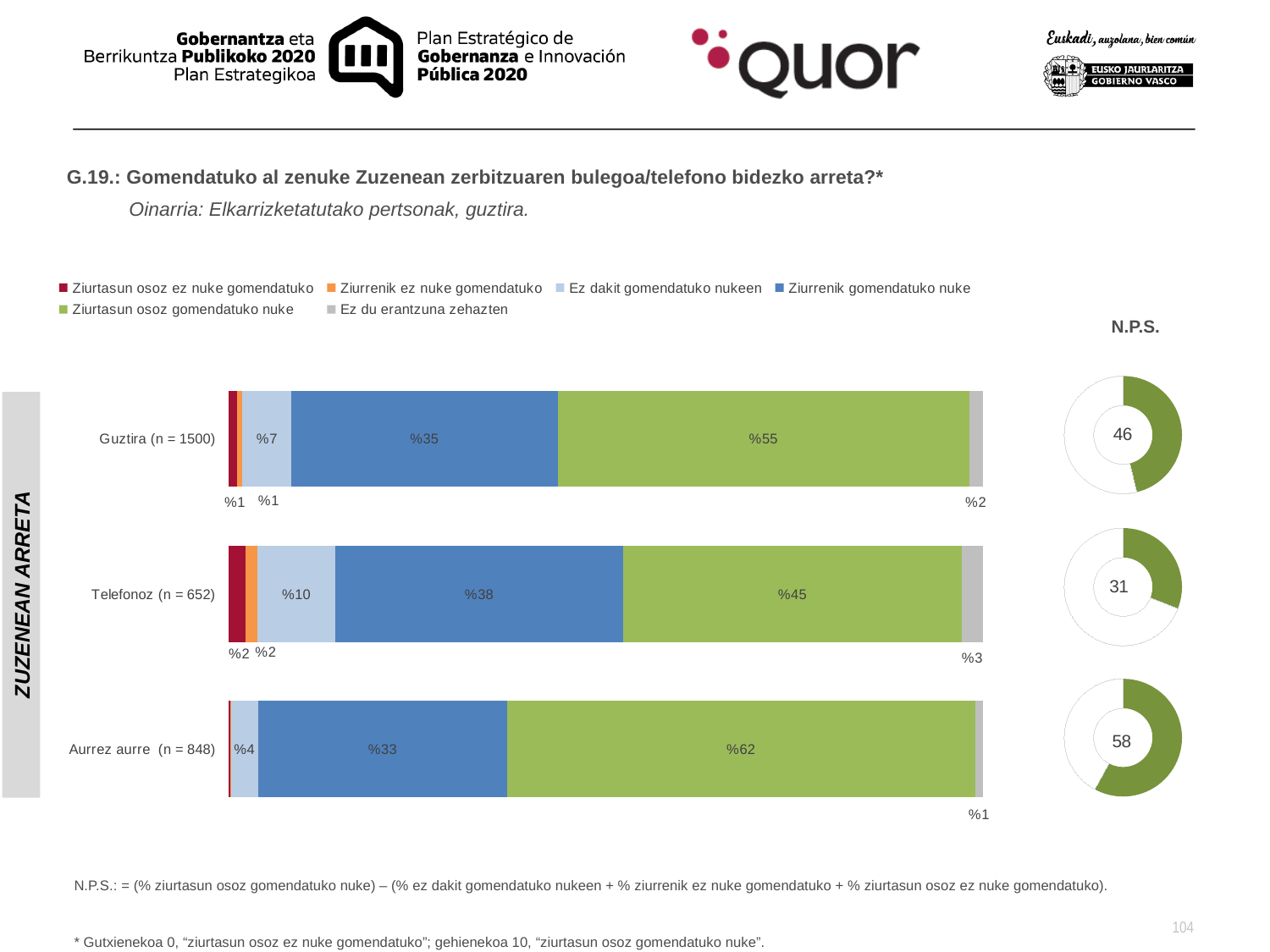
In the stacked bar chart, what is the value for "Ez dakit gomendatuko nukeen" for Aurrez aurre (n = 848)? %4 What is the N.P.S. value shown in the donut chart for Telefonoz (n = 652)? 31 In the stacked bar chart, what is the difference between the "Ziurtasun osoz gomendatuko nuke" values for Aurrez aurre (n = 848) and Telefonoz (n = 652)? 17 percentage points How many series does the legend of the stacked bar chart list? 6 In the stacked bar chart, which is larger: the "Ez dakit gomendatuko nukeen" value for Telefonoz (n = 652) or for Guztira (n = 1500)? Telefonoz (n = 652) Which category has the highest N.P.S. value in the donut charts on the right? Aurrez aurre (n = 848) In the stacked bar chart, what is the value for "Ez du erantzuna zehazten" for Telefonoz (n = 652)? %3 How many categories (bars) does the stacked bar chart show? 3 In the stacked bar chart, what is the value for "Ziurrenik gomendatuko nuke" for Telefonoz (n = 652)? %38 In the stacked bar chart, which category has the lowest value for "Ziurtasun osoz gomendatuko nuke"? Telefonoz (n = 652) In the stacked bar chart, which category has the highest value for "Ziurtasun osoz gomendatuko nuke"? Aurrez aurre (n = 848) In the stacked bar chart, what is the value for "Ziurtasun osoz gomendatuko nuke" for Guztira (n = 1500)? %55